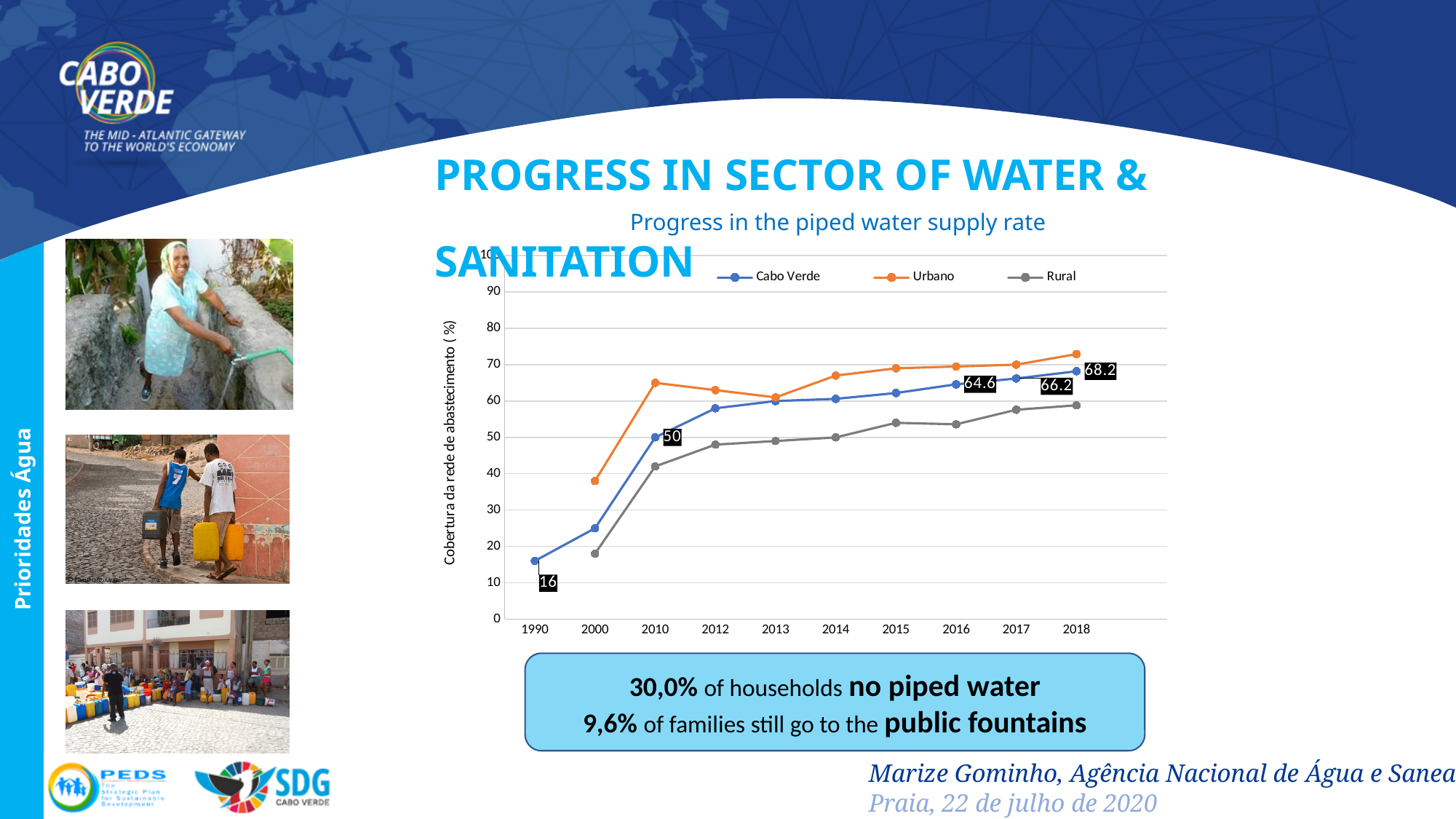
Is the value for Urbano in 2010 greater or less than 60? greater By how much did the Cabo Verde value increase from 1990 to 2018? 52.2 What is the difference between the Cabo Verde values for 2017 and 2016? 1.6 What is the value for Cabo Verde in 1990? 16 Which series has the lowest value in 2018? Rural Does the Cabo Verde series rise or fall from 1990 to 2018? rise What is the value for Cabo Verde in 2018? 68.2 What is the value for Cabo Verde in 2016? 64.6 How many series does the legend of the chart list? 3 How many years are shown on the x axis of the chart? 10 What type of chart is shown on the slide? line chart Which series has the highest value in 2018? Urbano